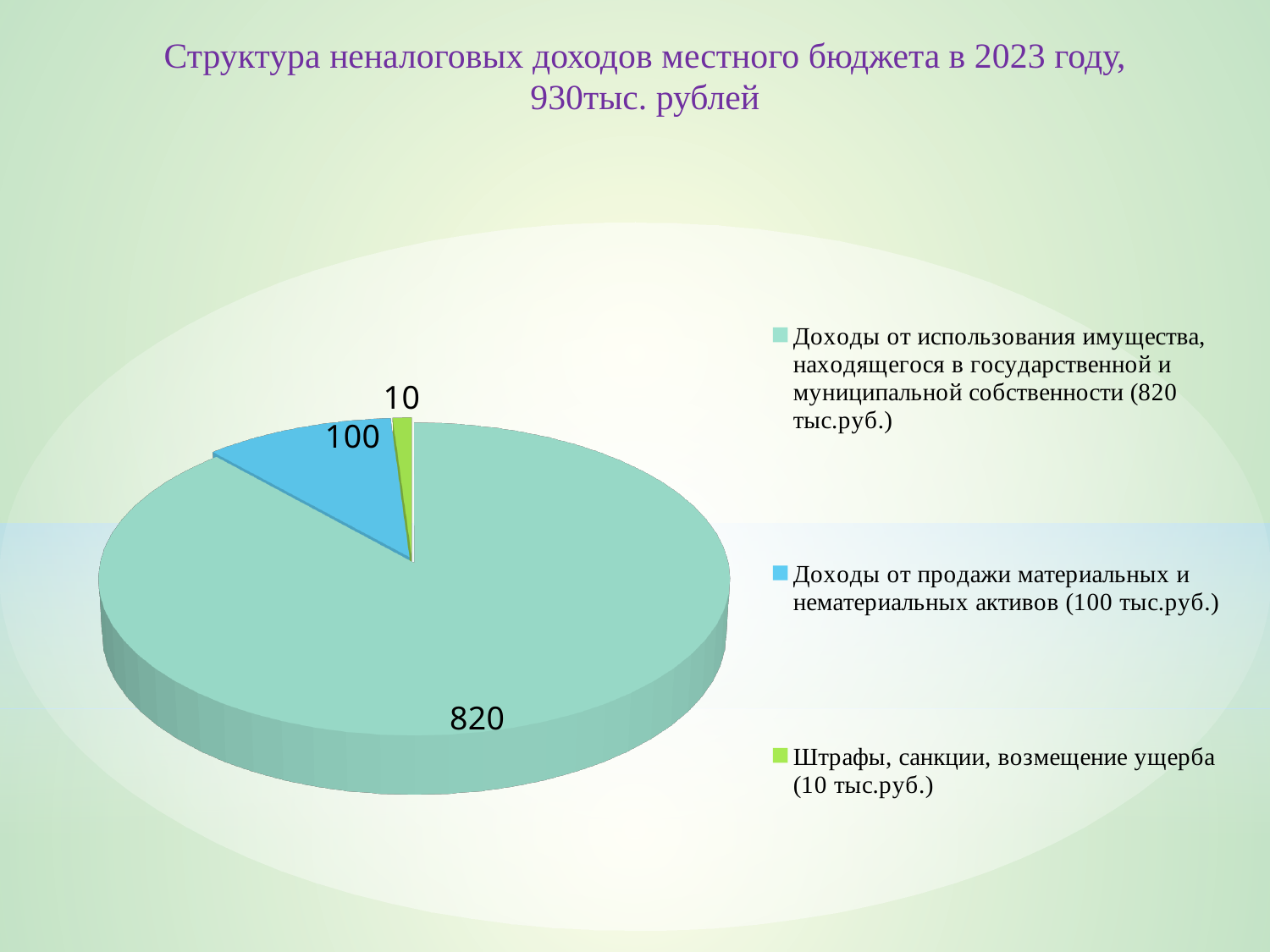
What is the value for "Штрафы, санкции, возмещение ущерба"? 10 What is the value for "Доходы от использования имущества, находящегося в государственной и муниципальной собственности"? 820 What is the title of the chart on the slide? Структура неналоговых доходов местного бюджета в 2023 году, 930тыс. рублей What is the value for "Доходы от продажи материальных и нематериальных активов"? 100 What is the difference between the value for "Доходы от продажи материальных и нематериальных активов" and the value for "Штрафы, санкции, возмещение ущерба"? 90 Which category has the smallest slice of the pie? Штрафы, санкции, возмещение ущерба What is the difference between the value for "Доходы от использования имущества" and the value for "Доходы от продажи материальных и нематериальных активов"? 720 Which category has the largest slice of the pie? Доходы от использования имущества, находящегося в государственной и муниципальной собственности How many categories does the pie chart have? 3 What type of chart is shown on the slide? Pie chart What is the total of all slices in the pie chart? 930 Which is larger: the value for "Доходы от продажи материальных и нематериальных активов" or the value for "Штрафы, санкции, возмещение ущерба"? Доходы от продажи материальных и нематериальных активов